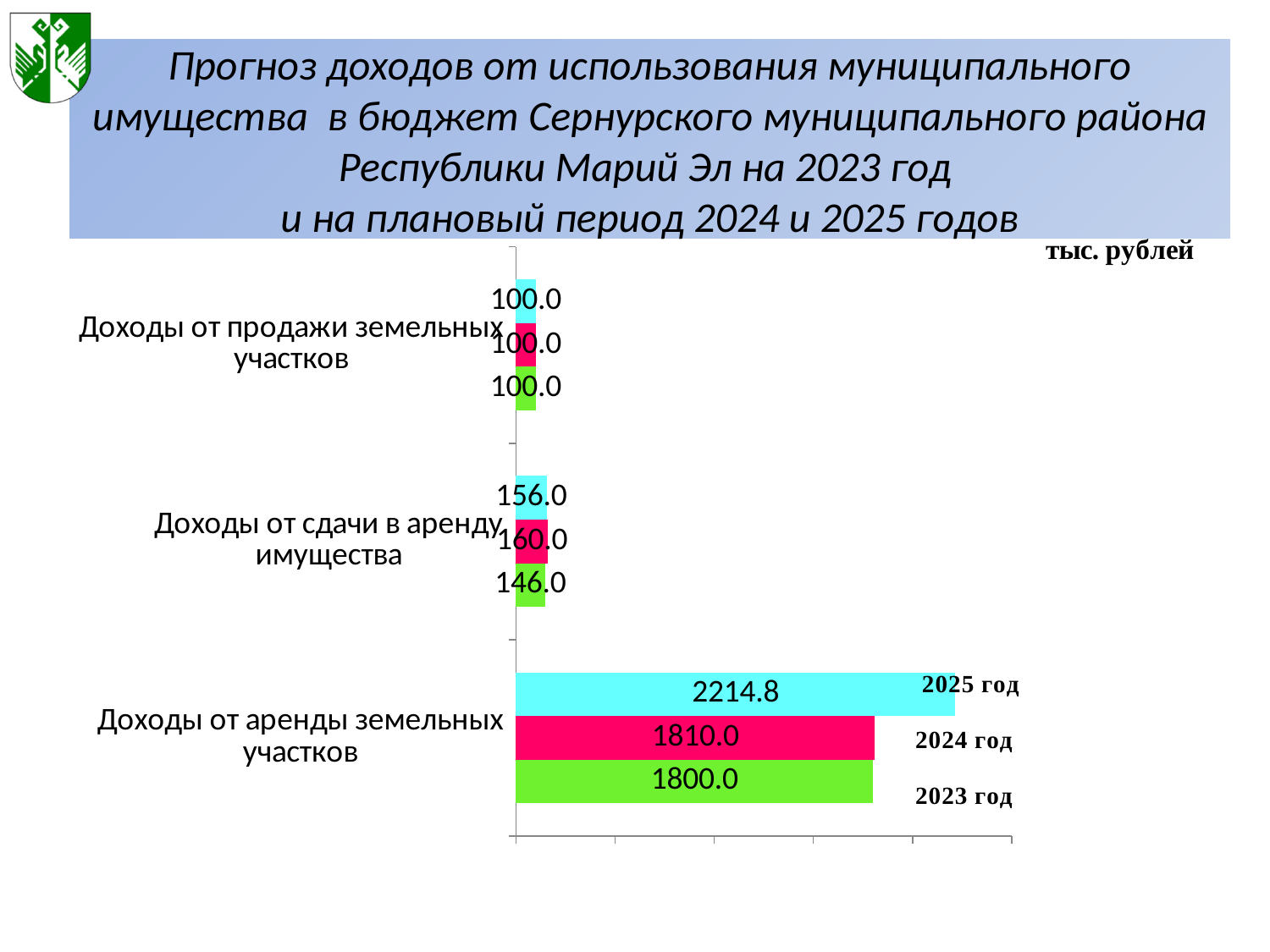
What is the difference between the 2024 год and 2023 год values for 'Доходы от сдачи в аренду имущества'? 14.0 What kind of chart is shown on the slide? bar chart Which category has the highest value in 2025 год? Доходы от аренды земельных участков What unit of measurement is indicated in the top right corner of the chart? тыс. рублей What is the value for 'Доходы от продажи земельных участков' in 2025 год? 100.0 For 'Доходы от сдачи в аренду имущества', which year has the larger value: 2024 год or 2023 год? 2024 год What is the value for 'Доходы от аренды земельных участков' in 2025 год? 2214.8 What is the value for 'Доходы от сдачи в аренду имущества' in 2024 год? 160.0 What is the difference between the 2025 год and 2024 год values for 'Доходы от аренды земельных участков'? 404.8 How many categories are shown on the chart? 3 Which category has the lowest value in 2023 год? Доходы от продажи земельных участков What is the value for 'Доходы от аренды земельных участков' in 2023 год? 1800.0